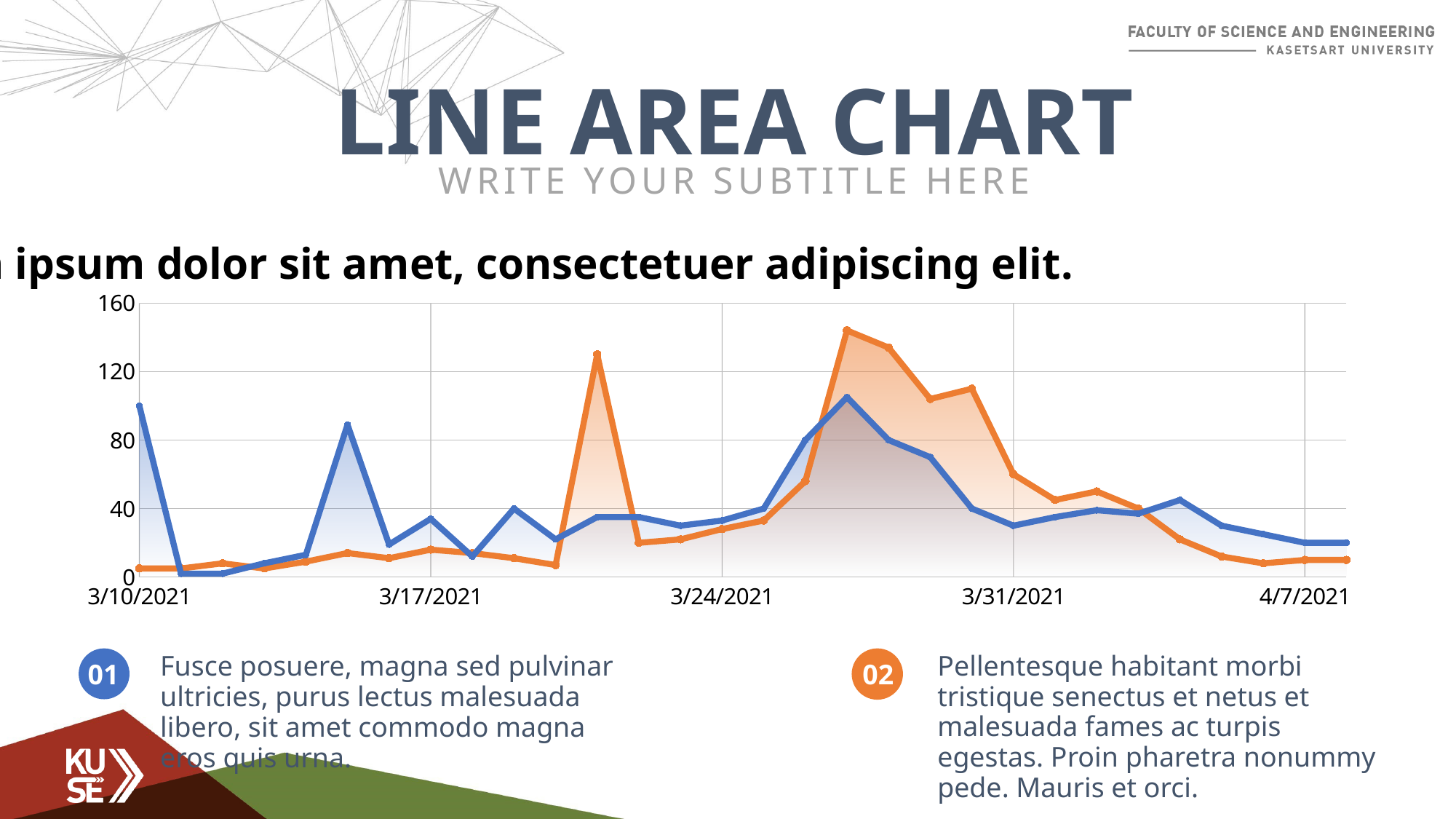
Is the value of the blue series at 3/10/2021 greater or less than 80? greater What is the title of the slide containing the chart? LINE AREA CHART What kind of chart is shown on the slide? line area chart Is the peak value of the orange series greater or less than 120? greater How many data series are plotted on the chart? 2 At 3/31/2021, which series has the larger value, the blue or the orange? orange How many date labels are shown on the x axis of the chart? 5 Is the value of the orange series at 4/7/2021 greater or less than 40? less At 3/10/2021, which series has the larger value, the blue or the orange? blue What is the highest value shown on the y axis of the chart? 160